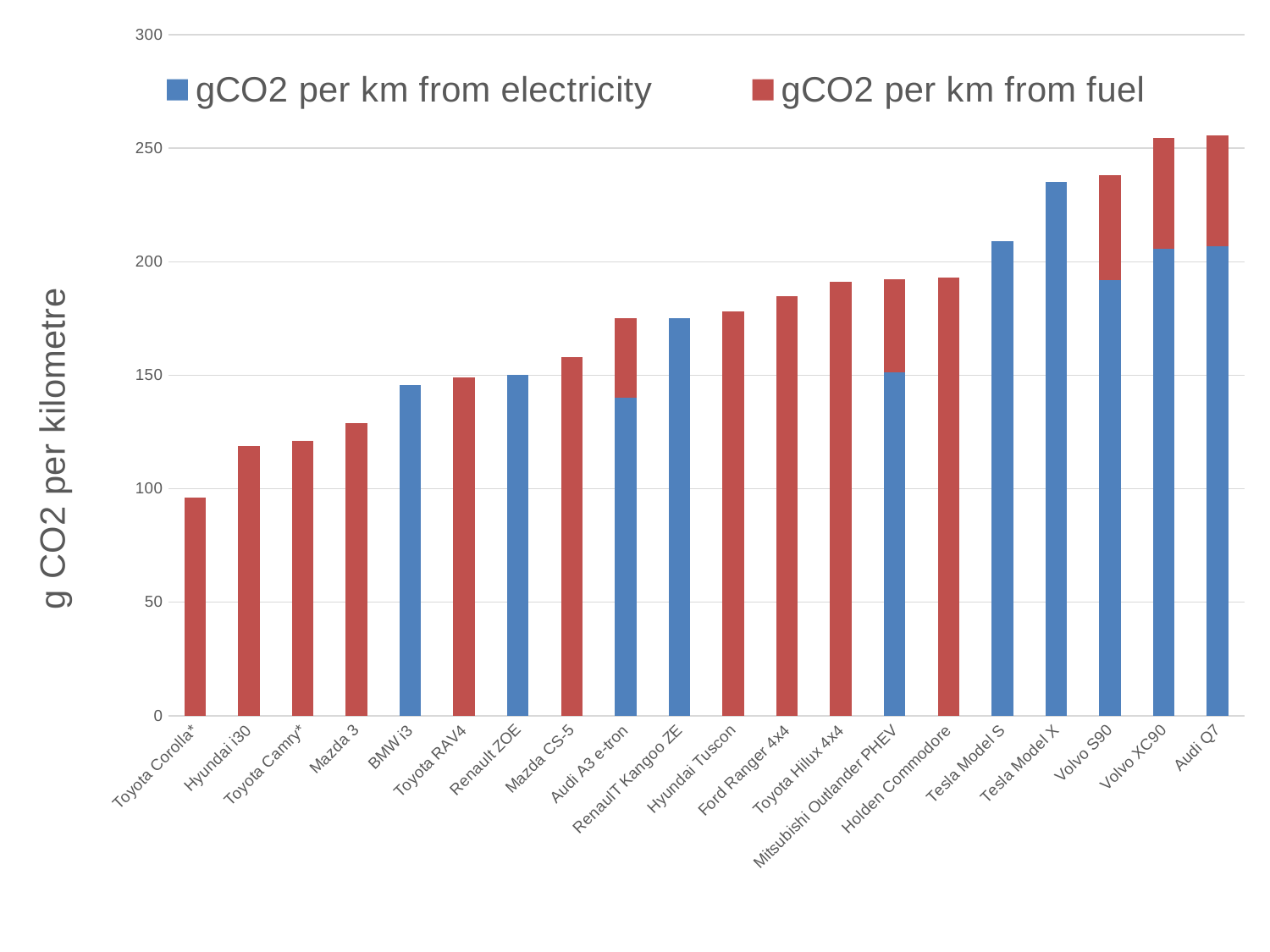
Is the value for Toyota Corolla* greater or less than 100? less Which has the higher g CO2 per kilometre, Tesla Model S or Tesla Model X? Tesla Model X What is the title of the vertical axis? g CO2 per kilometre Is the value for Mazda 3 greater or less than 100? greater Is the value for Tesla Model X greater or less than 200? greater What kind of chart is shown on the slide? bar chart Do the total values rise or fall moving from left to right along the x axis? rise How many series does the legend list? 2 How many vehicle categories are plotted on the x axis? 20 Which vehicle has the lowest total g CO2 per kilometre? Toyota Corolla* Which series is shown in blue? gCO2 per km from electricity